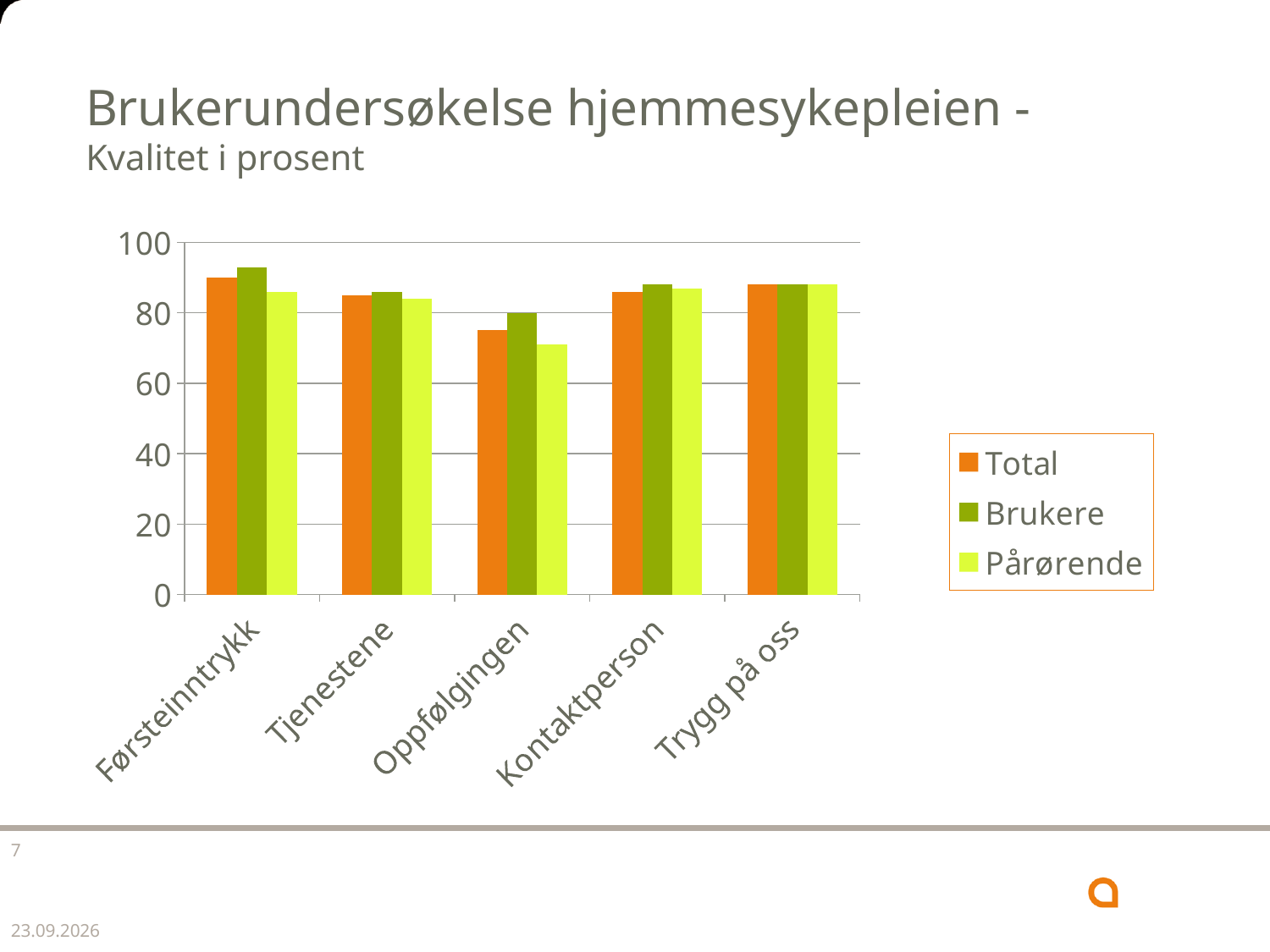
Which category has the lowest value for the Pårørende series? Oppfølgingen Which is larger: the Total value for Førsteinntrykk or the Total value for Oppfølgingen? Førsteinntrykk Is the Brukere value for Førsteinntrykk greater or less than 80? greater Is the Pårørende value for Oppfølgingen greater or less than 80? less Which category has the highest value for the Brukere series? Førsteinntrykk How many categories are shown on the x axis of the chart? 5 Is the Total value for Oppfølgingen greater or less than 80? less Which category has the lowest value for the Total series? Oppfølgingen How many series does the chart's legend list? 3 For Oppfølgingen, which series has the larger value: Brukere or Pårørende? Brukere What kind of chart is shown on the slide? bar chart What are the three series listed in the chart's legend? Total, Brukere, Pårørende